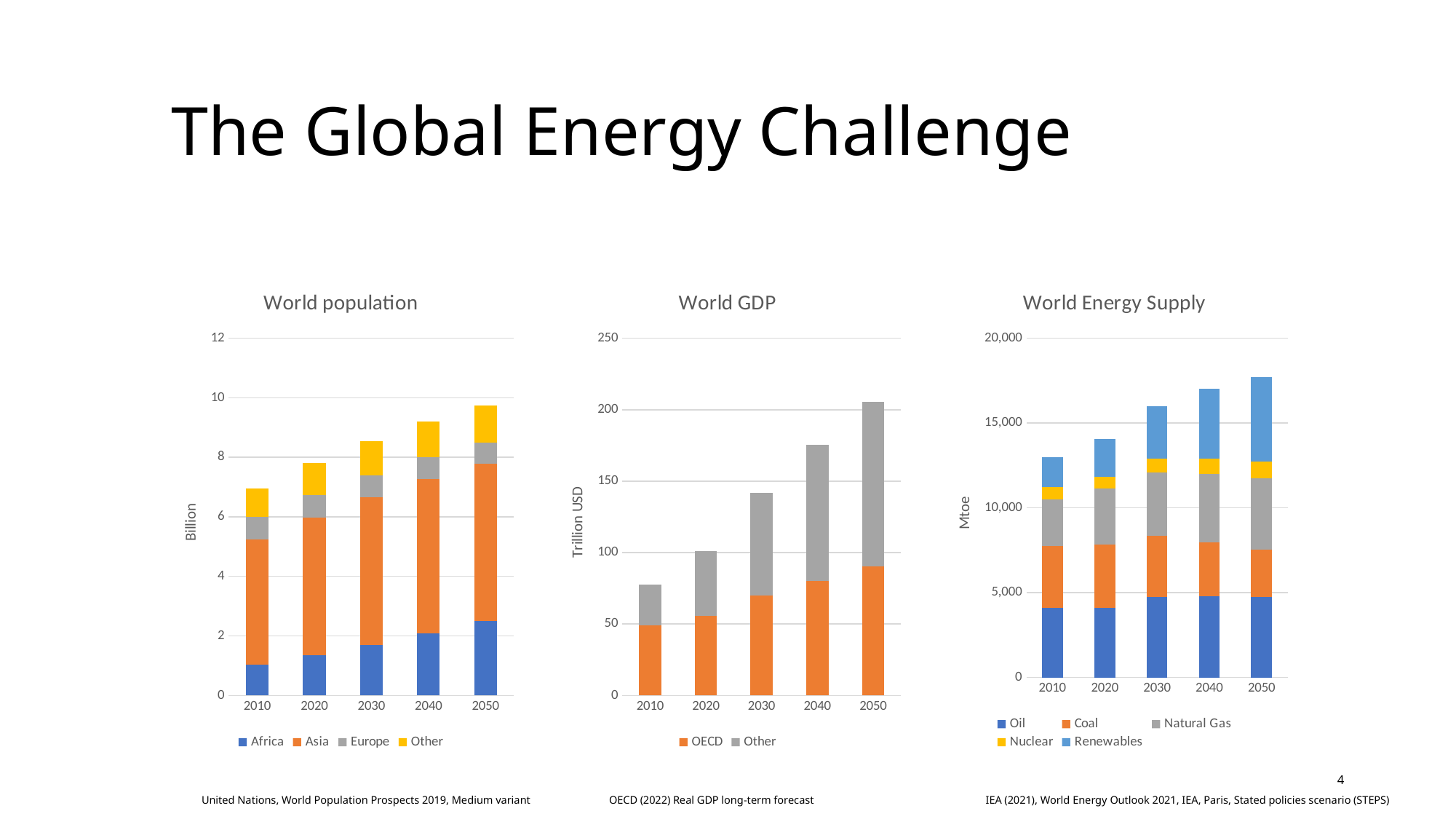
How many series does the legend of the World Energy Supply chart list? 5 What is the y-axis label of the World GDP chart? Trillion USD How many years are shown on the x axis of the World population chart? 5 In the World population chart, is the total for 2050 greater or less than 8 billion? greater In the World Energy Supply chart, does the total energy supply rise or fall from 2010 to 2050? rise In the World GDP chart, is the total for 2010 greater or less than 100 trillion USD? less In the World population chart, which year has the highest total population? 2050 In the World GDP chart, which year has the lowest total GDP? 2010 What kind of chart is the World population chart? stacked bar chart How many series does the legend of the World GDP chart list? 2 In the World Energy Supply chart, is the total for 2050 greater or less than 15,000 Mtoe? greater In the World GDP chart, which is larger in 2050: OECD or Other? Other